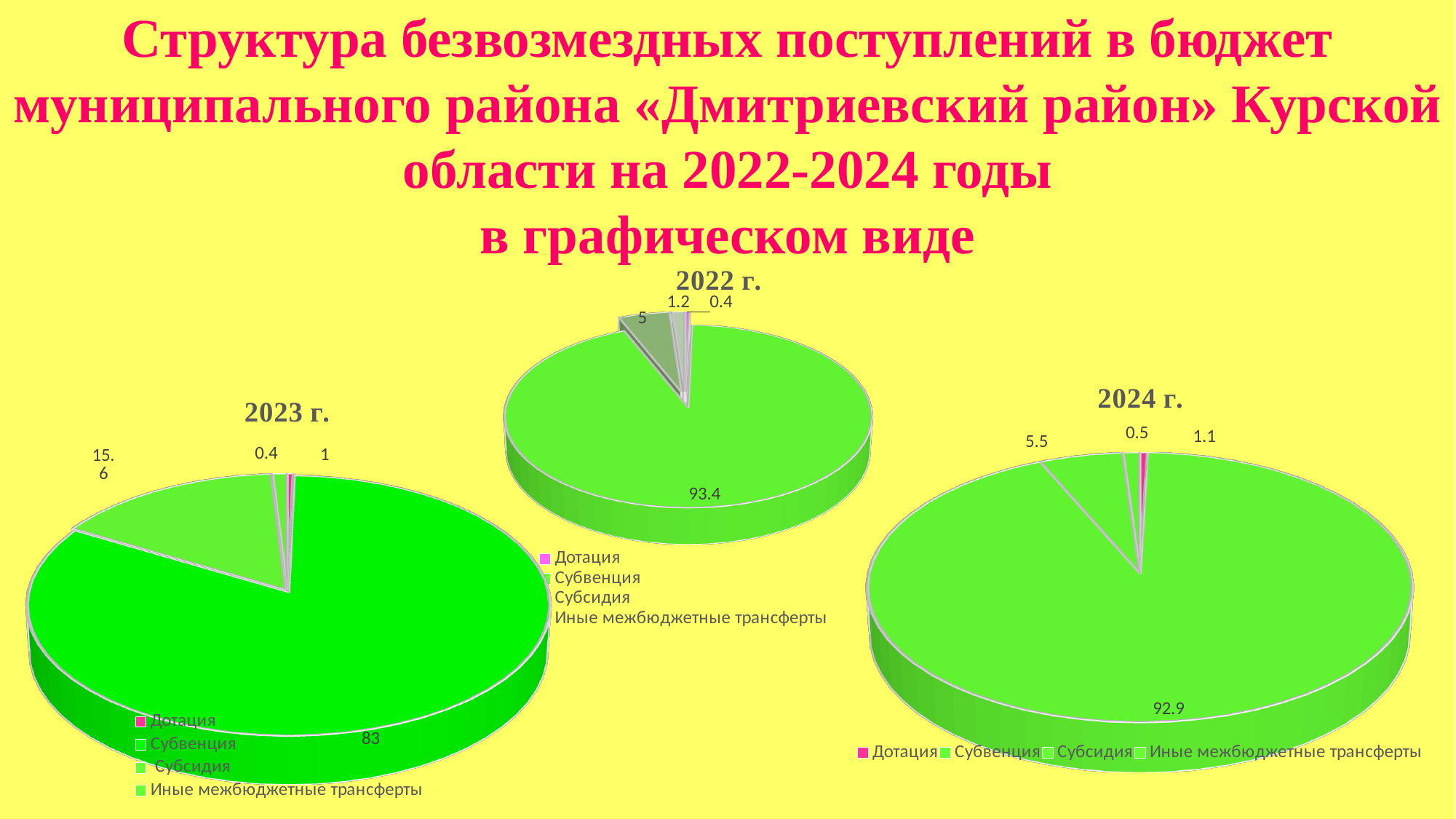
What is the largest value shown on the 2022 г. pie chart? 93.4 How many entries does the legend of the 2024 г. chart list? 4 What is the smallest value shown on the 2022 г. pie chart? 0.4 What is the largest value shown on the 2023 г. pie chart? 83 What is the second largest value shown on the 2023 г. pie chart? 15.6 What is the second largest value shown on the 2024 г. pie chart? 5.5 What is the difference between the largest value on the 2022 г. chart (93.4) and the largest value on the 2023 г. chart (83)? 10.4 What is the smallest value shown on the 2024 г. pie chart? 0.5 What is the largest value shown on the 2024 г. pie chart? 92.9 Which is larger: the largest slice of the 2022 г. chart or the largest slice of the 2023 г. chart? 2022 г. (93.4) How many slices does the 2023 г. pie chart have? 4 What kind of chart is used for the 2022 г. data? Pie chart